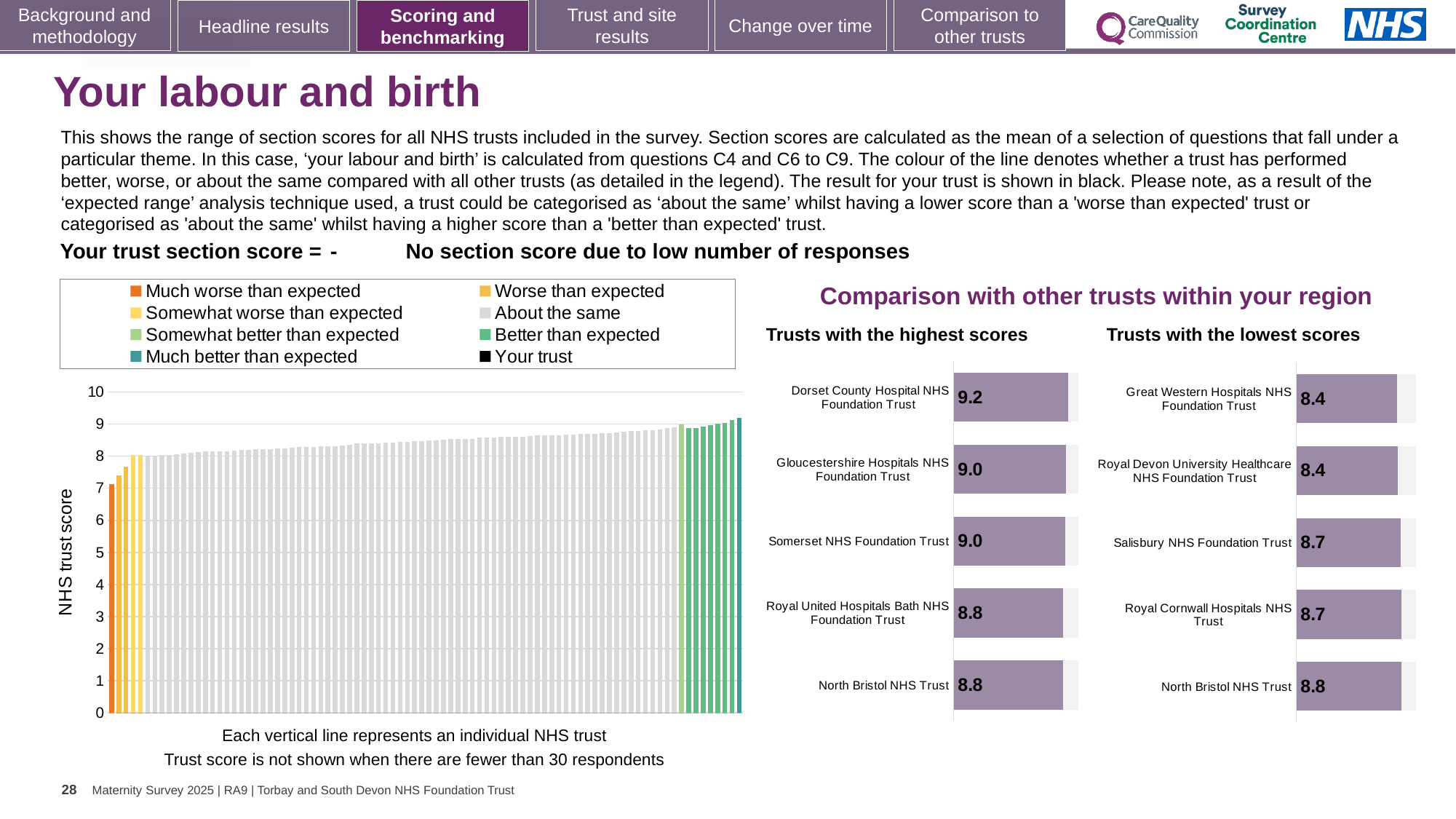
In the large 'NHS trust score' chart on the left, is the value of the tallest bar greater or less than 9? greater In the 'Trusts with the lowest scores' chart, which is larger: the score for Great Western Hospitals NHS Foundation Trust or the score for North Bristol NHS Trust? North Bristol NHS Trust In the 'Trusts with the lowest scores' chart, what is the score for Salisbury NHS Foundation Trust? 8.7 In the 'Trusts with the highest scores' chart, which trust has the highest score? Dorset County Hospital NHS Foundation Trust In the 'Trusts with the highest scores' chart, what is the score for Somerset NHS Foundation Trust? 9.0 How many entries does the legend above the large 'NHS trust score' chart list? 8 In the 'Trusts with the highest scores' chart, what is the score for Dorset County Hospital NHS Foundation Trust? 9.2 In the 'Trusts with the highest scores' chart, what is the difference between the scores of Dorset County Hospital NHS Foundation Trust and North Bristol NHS Trust? 0.4 How many trusts are listed in the 'Trusts with the highest scores' chart? 5 In the large 'NHS trust score' chart on the left, do the values rise or fall from left to right along the x axis? Rise In the 'Trusts with the lowest scores' chart, what is the score for Royal Devon University Healthcare NHS Foundation Trust? 8.4 What kind of chart is the large chart on the left with the 'NHS trust score' axis? Bar chart